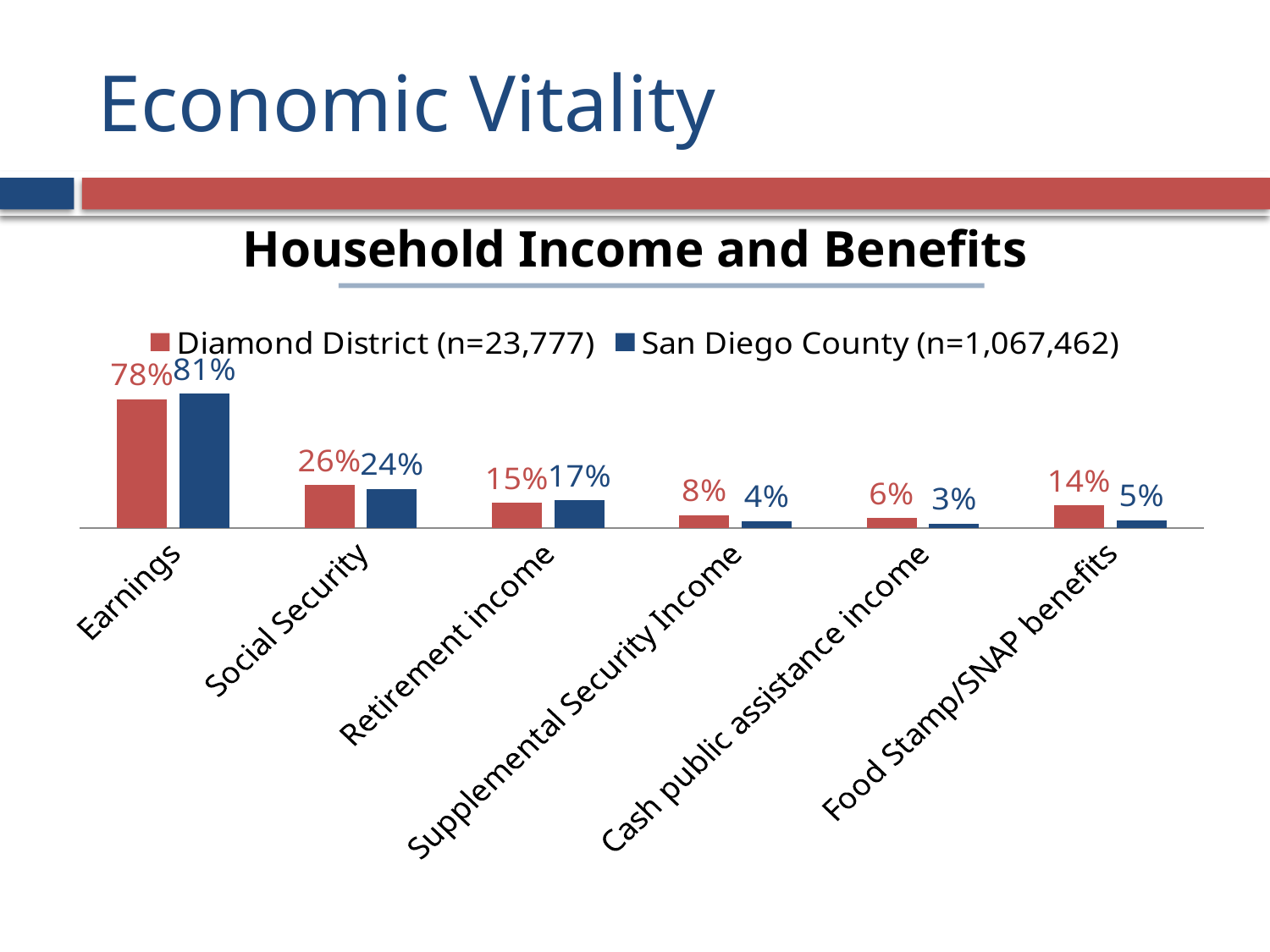
Which category has the highest San Diego County value? Earnings What is the Diamond District value for Supplemental Security Income? 8% What is the Diamond District value for Earnings? 78% What is the difference between the Diamond District and San Diego County values for Food Stamp/SNAP benefits? 9% What kind of chart is shown on the slide? Bar chart Which is larger for Social Security: Diamond District or San Diego County? Diamond District Which is larger for Retirement income: Diamond District or San Diego County? San Diego County What is the difference between the San Diego County and Diamond District values for Earnings? 3% What is the San Diego County value for Food Stamp/SNAP benefits? 5% How many categories are shown on the x axis? 6 How many series does the legend list? 2 Which category has the lowest Diamond District value? Cash public assistance income